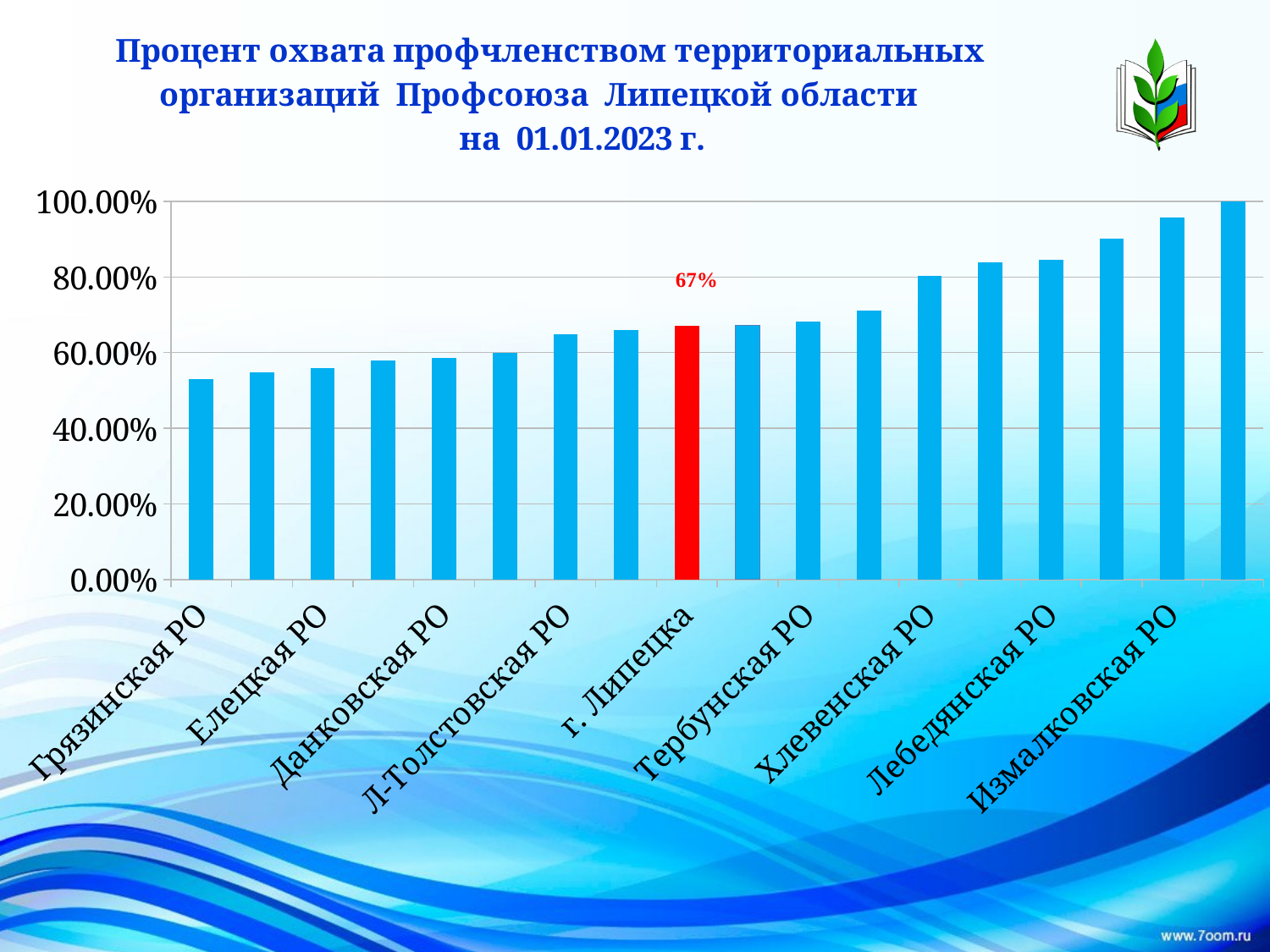
What is the value shown for г. Липецка? 67% Is the value for Лебедянская РО greater or less than 80%? greater How many bars are plotted in the chart? 18 Which labelled category has the lowest value? Грязинская РО Is the value for Измалковская РО greater or less than 80%? greater Do the values rise or fall from left to right along the x axis? rise Which has the larger value, Елецкая РО or Хлевенская РО? Хлевенская РО Is the value for Елецкая РО greater or less than 60%? less What colour is the bar for г. Липецка? red What kind of chart is shown on the slide? bar chart